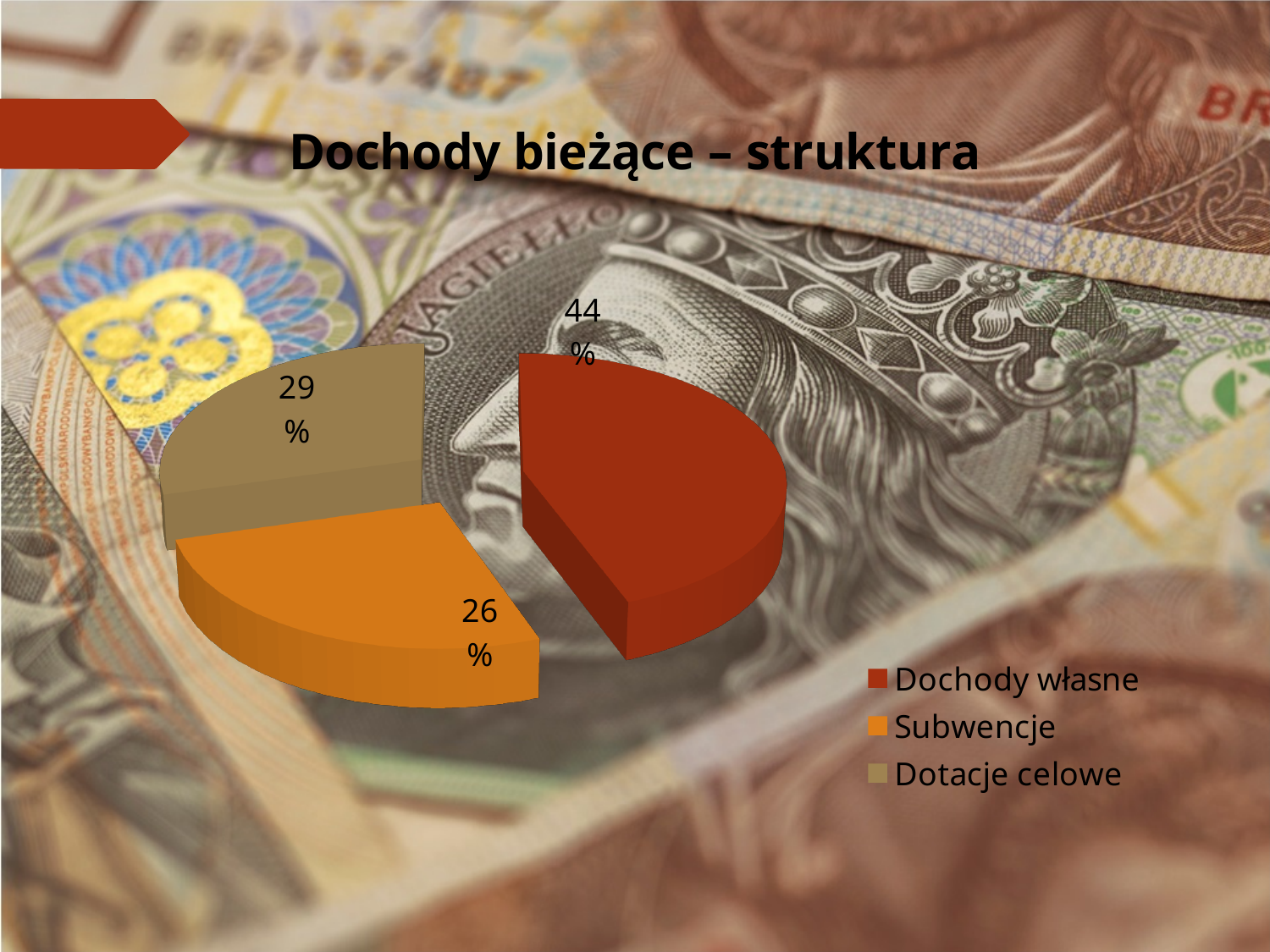
What is the difference in percentage points between Dotacje celowe and Subwencje? 3 Which colour represents Subwencje in the legend? Orange What share of the pie does Dotacje celowe have? 29% Which category has the smallest slice of the pie? Subwencje What share of the pie does Dochody własne have? 44% Which is larger, the share for Dotacje celowe or the share for Subwencje? Dotacje celowe What is the difference in percentage points between Dochody własne and Subwencje? 18 Which category has the largest slice of the pie? Dochody własne What share of the pie does Subwencje have? 26% What kind of chart is shown on the slide? Pie chart What is the title of the chart slide? Dochody bieżące – struktura How many slices does the pie chart have? 3